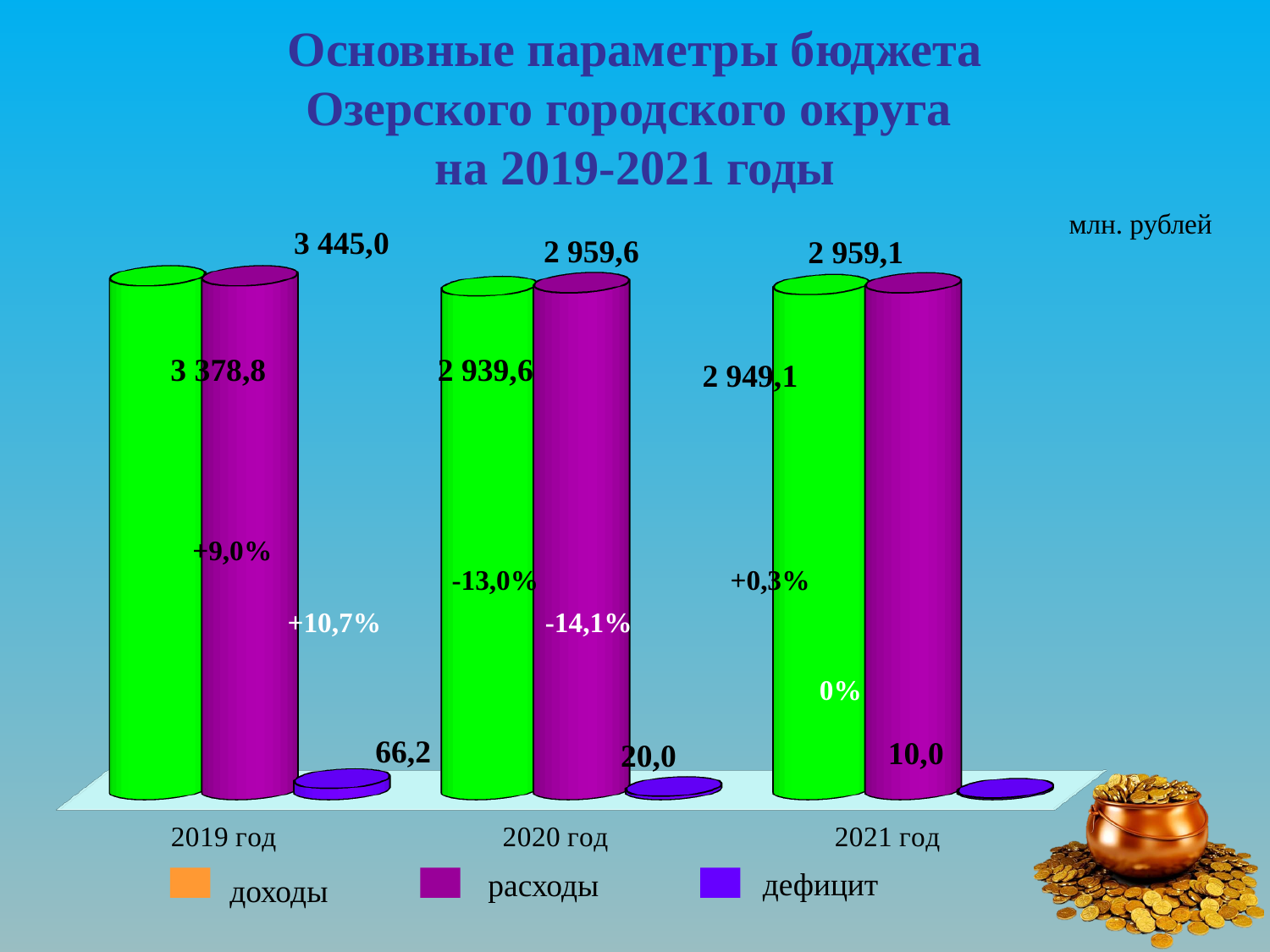
In which year is the дефицит lowest? 2021 год How many years are shown on the x axis? 3 What is the difference between расходы and доходы in 2020 год? 20,0 What is the value of расходы for 2019 год? 3 445,0 What kind of chart is shown on the slide? bar chart Which is larger, доходы in 2019 год or доходы in 2020 год? доходы in 2019 год What is the value of доходы for 2020 год? 2 939,6 What is the value of дефицит for 2021 год? 10,0 What is the difference between расходы and доходы in 2019 год? 66,2 How many series does the legend list? 3 In which year is the дефицит highest? 2019 год What is the value of доходы for 2021 год? 2 949,1